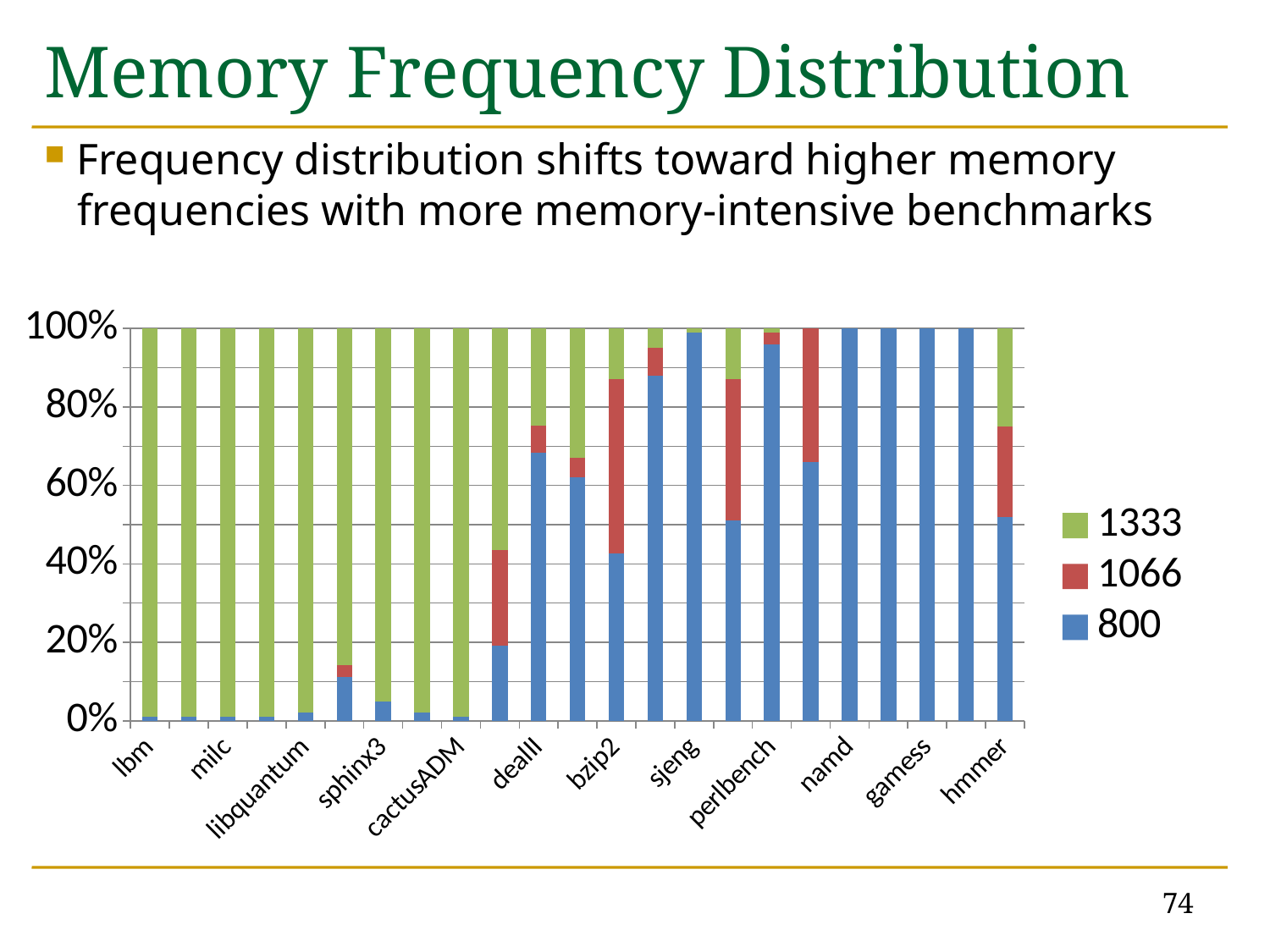
How many series does the legend list? 3 Is the share of the 800 series for sjeng greater or less than 80%? greater What kind of chart is shown on the slide? Stacked bar chart Which has a larger share of the 800 series, namd or lbm? namd Is the share of the 800 series for hmmer greater or less than 40%? greater Moving from left to right along the x axis, does the share of the 800 series generally rise or fall? rise Is the share of the 800 series for bzip2 greater or less than 60%? less Which colour represents the 1333 series? Green What are the three series named in the legend? 1333, 1066, 800 How many bars are plotted in the chart? 23